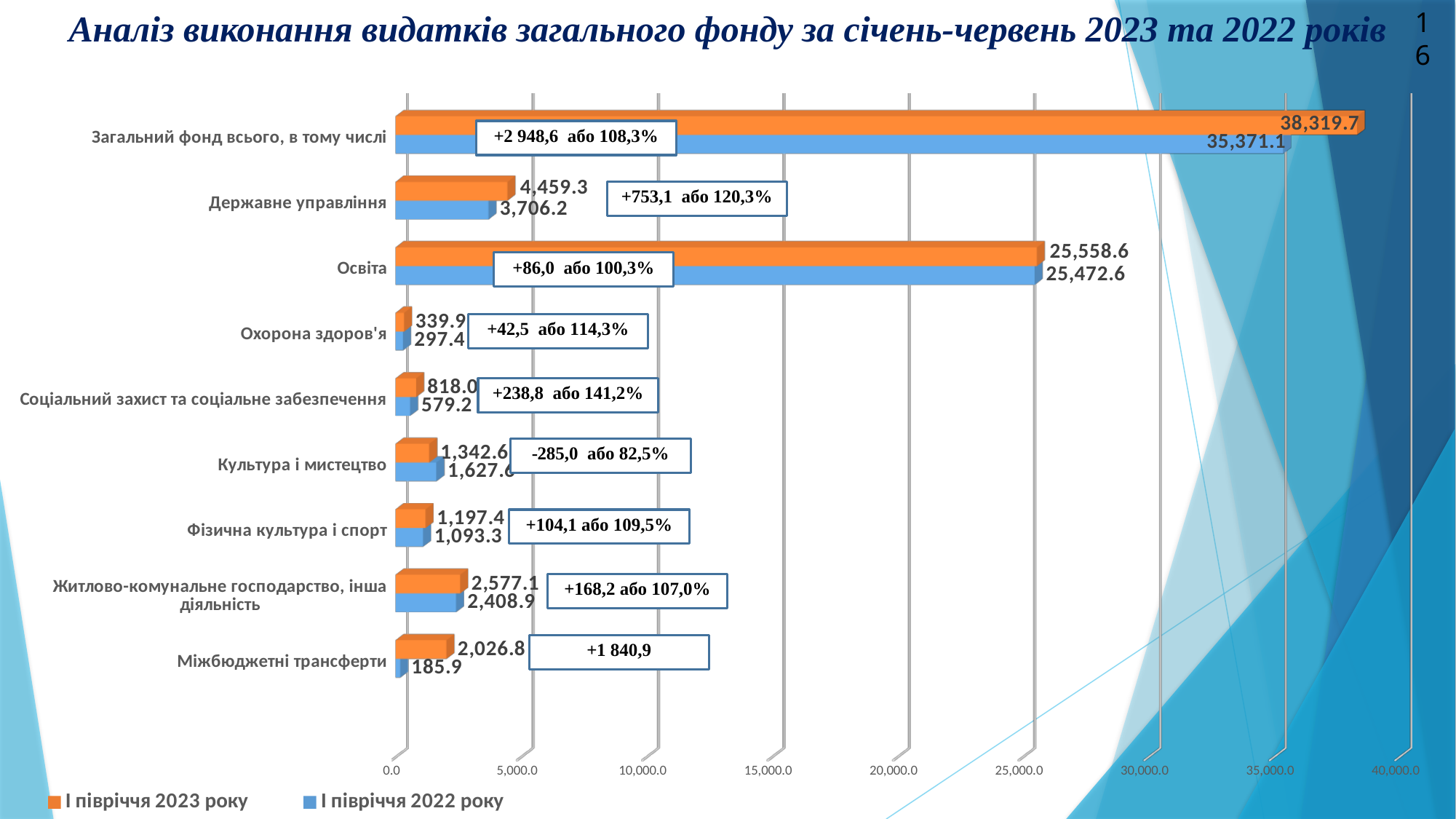
How many series does the legend list? 2 For Культура і мистецтво, which series has the larger value, І півріччя 2023 року or І півріччя 2022 року? І півріччя 2022 року How many categories are shown on the chart? 9 Which category has the highest value in the І півріччя 2022 року series? Загальний фонд всього, в тому числі What is the value for Освіта in the І півріччя 2023 року series? 25,558.6 What is the difference between the І півріччя 2023 року and І півріччя 2022 року values for Міжбюджетні трансферти? 1,840.9 What is the difference between the І півріччя 2023 року and І півріччя 2022 року values for Державне управління? 753.1 Which category has the lowest value in the І півріччя 2023 року series? Охорона здоров'я What is the value for Житлово-комунальне господарство, інша діяльність in the І півріччя 2023 року series? 2,577.1 What is the value for Державне управління in the І півріччя 2022 року series? 3,706.2 Is the І півріччя 2023 року value for Освіта greater or less than 25,000.0? greater What is the value for Міжбюджетні трансферти in the І півріччя 2022 року series? 185.9